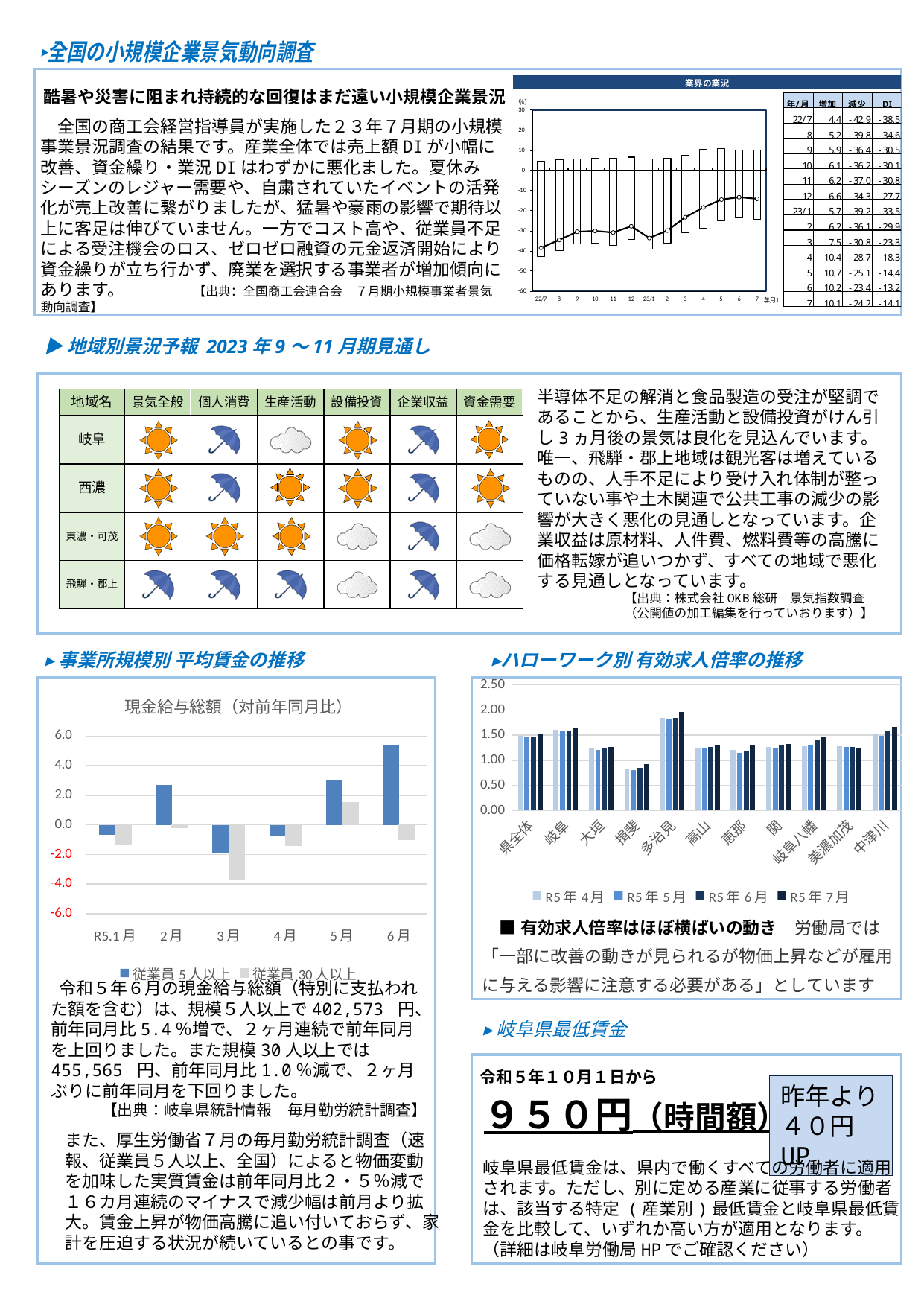
What kind of chart is the 現金給与総額（対前年同月比） chart on the lower left? bar chart How many series does the legend of the 現金給与総額（対前年同月比） chart list? 2 In the 現金給与総額（対前年同月比） chart, which month has the lowest value for 従業員30人以上? 3月 In the 現金給与総額（対前年同月比） chart, is the 3月 value for 従業員30人以上 greater or less than -2.0? less How many categories are shown on the x axis of the ハローワーク別 有効求人倍率の推移 chart? 11 How many months are shown on the x axis of the 現金給与総額（対前年同月比） chart? 6 In the 業界の業況 chart's table, what is the DI value for 23/7? -14.1 How many series does the legend of the ハローワーク別 有効求人倍率の推移 chart list? 4 In the 現金給与総額（対前年同月比） chart, which month has the highest value for 従業員5人以上? 6月 In the 現金給与総額（対前年同月比） chart, is the 6月 value for 従業員5人以上 greater or less than 4.0? greater In the ハローワーク別 有効求人倍率の推移 chart, is the R5年7月 value for 多治見 greater or less than 1.50? greater In the ハローワーク別 有効求人倍率の推移 chart, which category has the lowest values? 揖斐